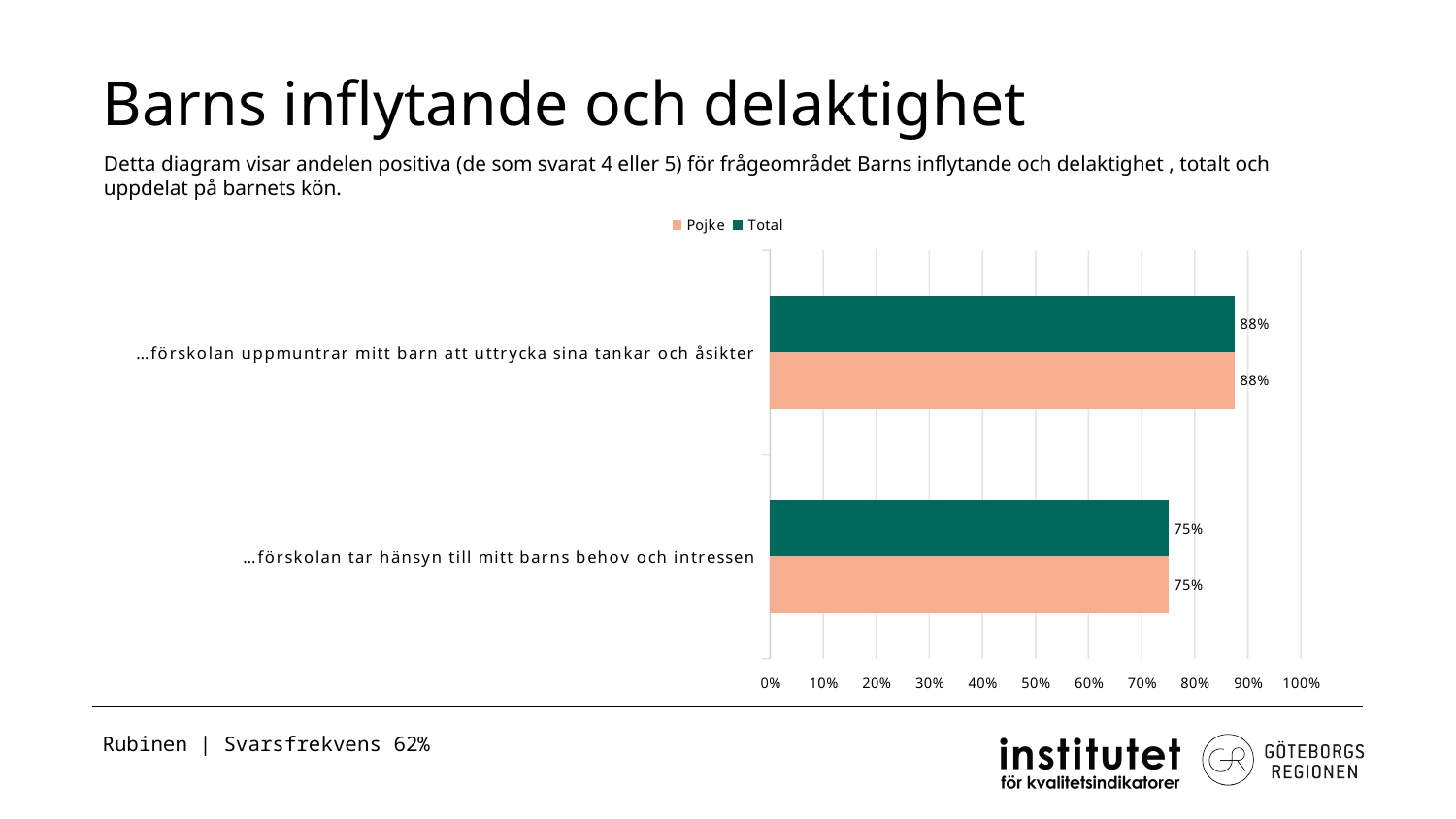
Which category has the lowest Pojke value? …förskolan tar hänsyn till mitt barns behov och intressen What is the Pojke value for "…förskolan tar hänsyn till mitt barns behov och intressen"? 75% How many categories are shown in the chart? 2 Which category has the highest Total value? …förskolan uppmuntrar mitt barn att uttrycka sina tankar och åsikter Which series is shown in dark green in the legend? Total What is the Pojke value for "…förskolan uppmuntrar mitt barn att uttrycka sina tankar och åsikter"? 88% How many series does the legend list? 2 What is the difference between the Total values for the two categories? 13% What is the Total value for "…förskolan uppmuntrar mitt barn att uttrycka sina tankar och åsikter"? 88% What is the Total value for "…förskolan tar hänsyn till mitt barns behov och intressen"? 75% What kind of chart is shown on the slide? bar chart Is the Pojke value for "…förskolan tar hänsyn till mitt barns behov och intressen" greater or less than 80%? less